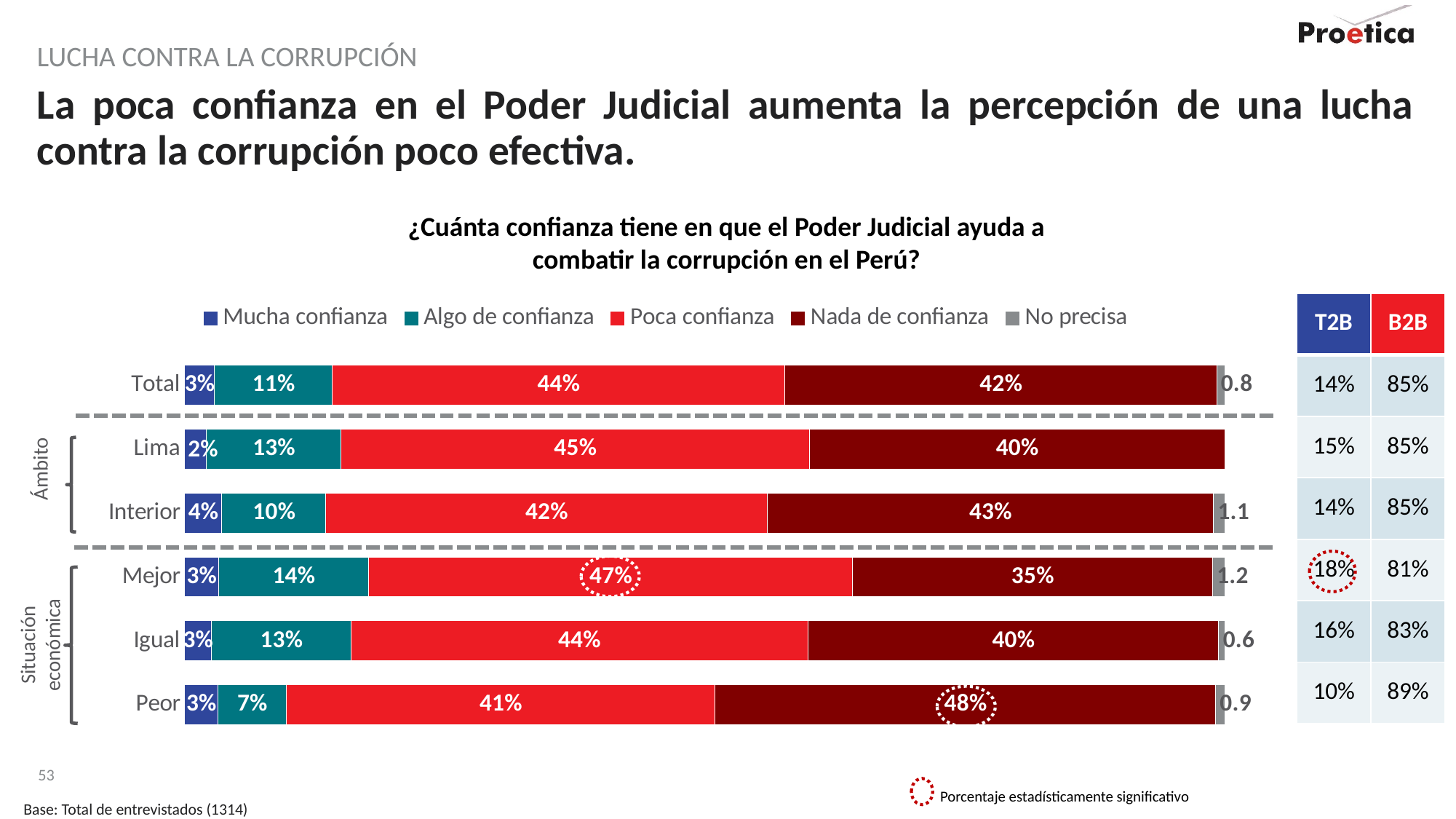
Which has a larger Poca confianza value, Lima or Interior? Lima What is the value of Algo de confianza for Mejor? 14% What kind of chart is shown on the slide? Stacked bar chart How many categories (bars) are shown in the chart? 6 What is the value of Mucha confianza for Interior? 4% Which category has the highest value for Poca confianza? Mejor What is the difference between the Nada de confianza values for Peor and Mejor? 13 percentage points How many series does the legend list? 5 Which category has the lowest value for Algo de confianza? Peor What is the value of Nada de confianza for Peor? 48% Which category has the highest value for Nada de confianza? Peor What is the value of Poca confianza for Lima? 45%